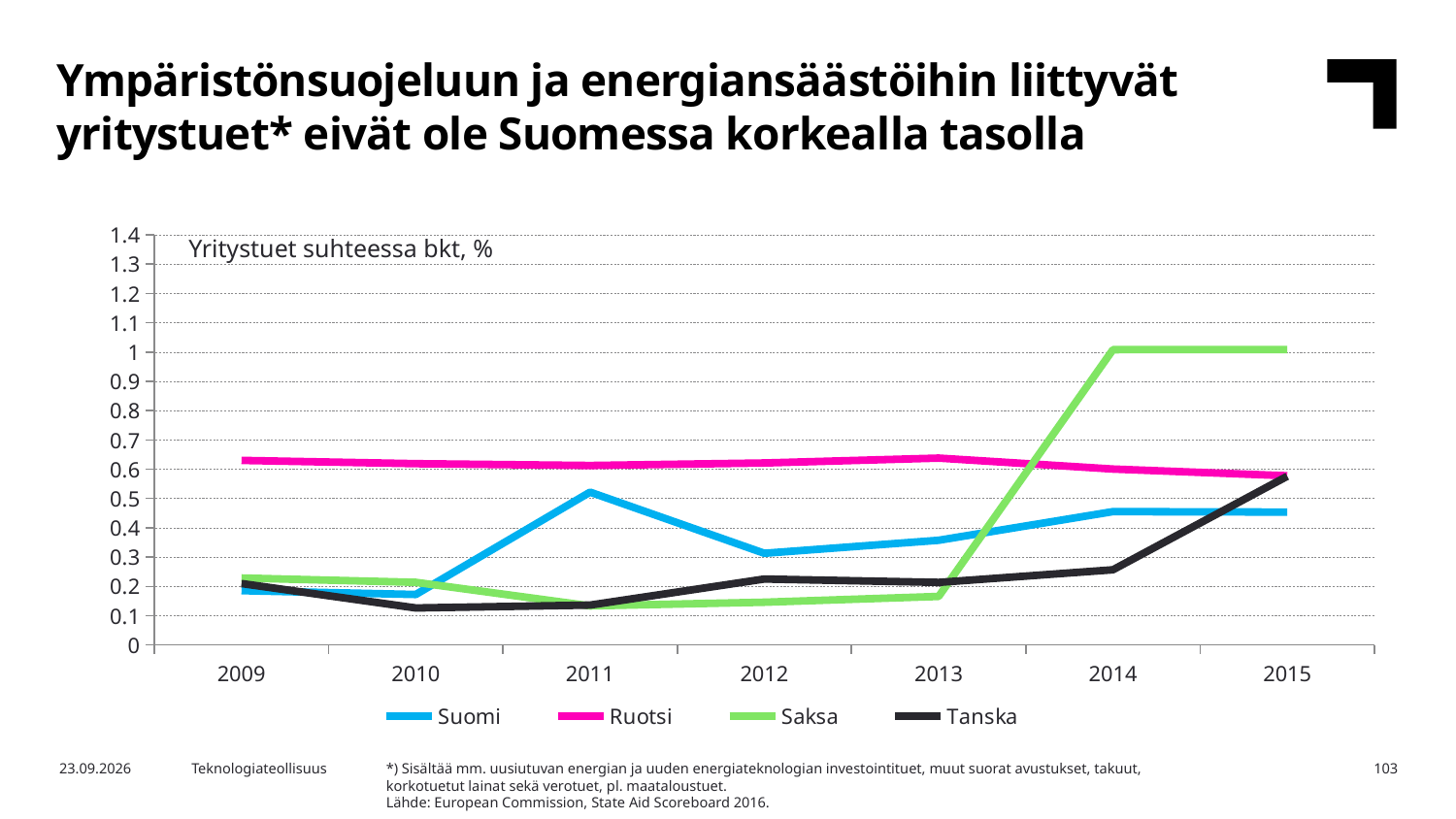
How many series does the legend list? 4 What kind of chart is shown on the slide? line chart Which series has the highest value in 2015? Saksa Is the value for Saksa in 2014 greater or less than 0.9? greater What is the label shown inside the plot area at the top of the chart? Yritystuet suhteessa bkt, % Which is larger: the value for Suomi in 2011 or in 2012? 2011 How many years are shown on the x axis? 7 Which series has the highest value in 2009? Ruotsi Does the value for Saksa rise or fall from 2013 to 2014? rise Is the value for Suomi in 2011 greater or less than 0.4? greater Which series has the lowest value in 2015? Suomi Is the value for Tanska in 2010 greater or less than 0.2? less